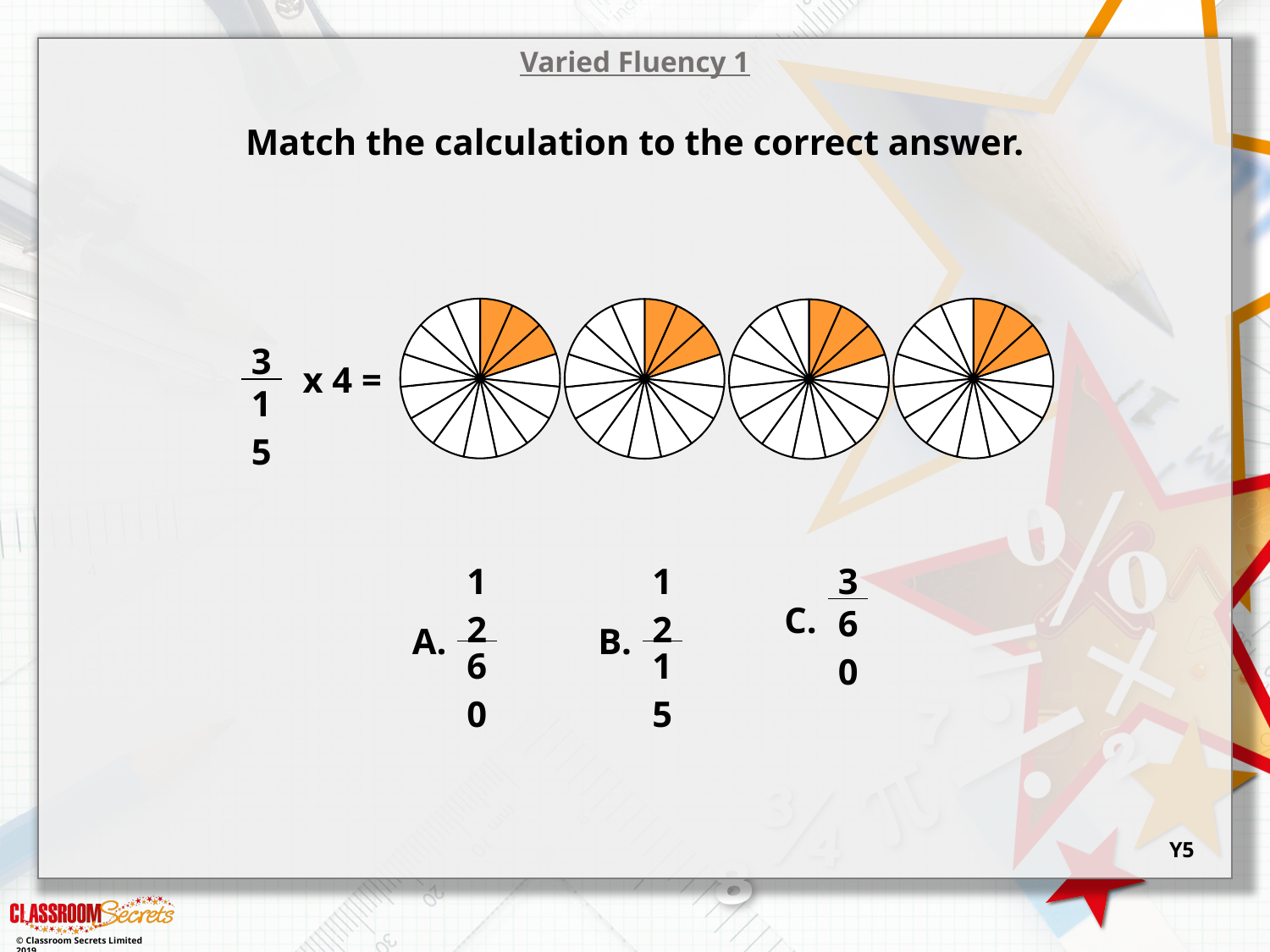
What colour are the shaded parts of the circles? Orange Is the number of shaded parts in each circle greater or less than the number of unshaded parts? less How many parts of each circle are shaded? 3 What fraction of each circle is shaded? 3/15 How many shaded parts are there in total across all four circles? 12 What calculation do the circle diagrams represent? 3/15 x 4 How many circle diagrams are shown on the slide? 4 Into how many equal parts is each circle divided? 15